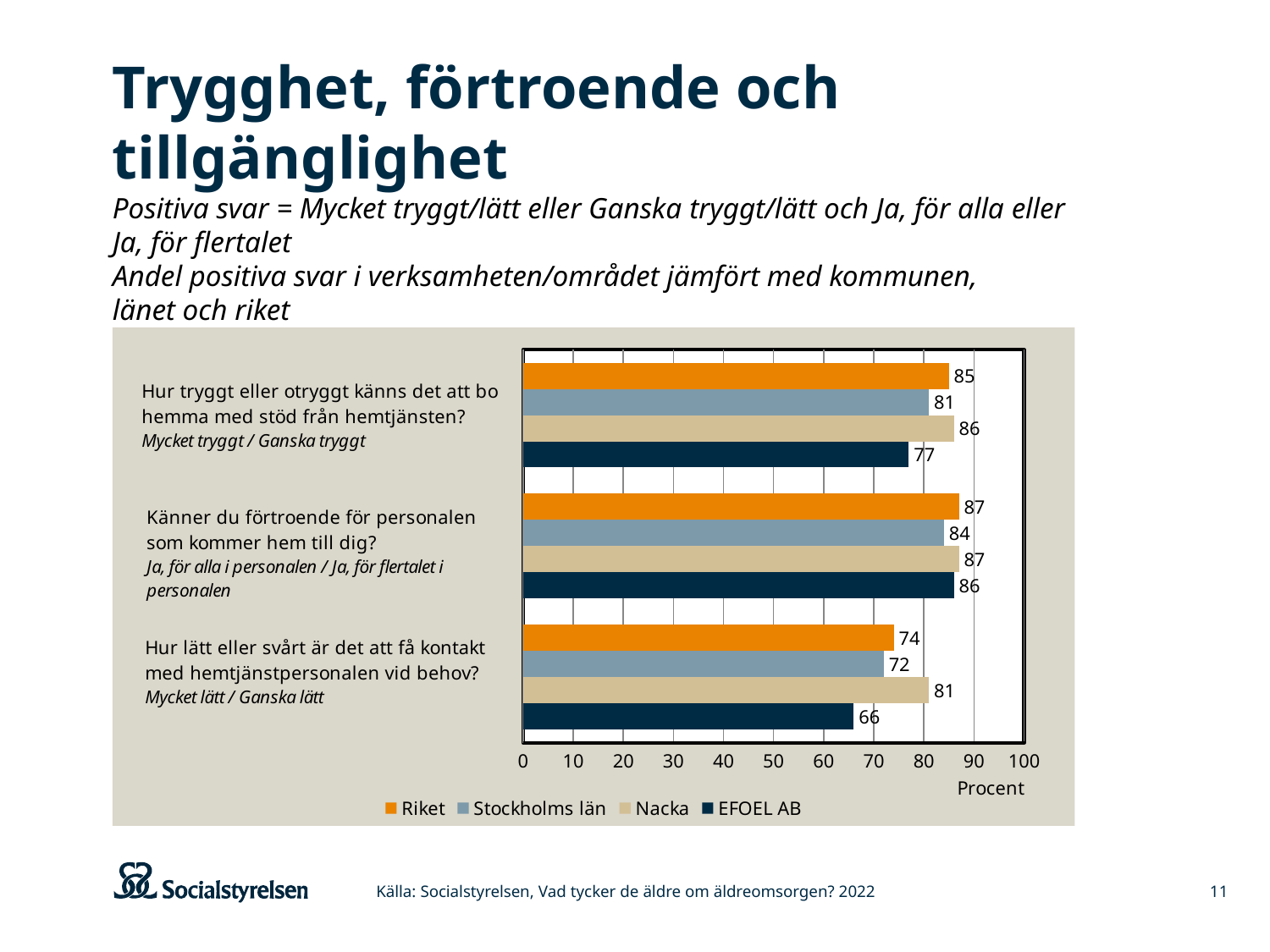
What is the value for EFOEL AB for the question "Hur tryggt eller otryggt känns det att bo hemma med stöd från hemtjänsten?"? 77 Which series has the highest value for the question "Hur tryggt eller otryggt känns det att bo hemma med stöd från hemtjänsten?"? Nacka What label is shown on the horizontal axis of the chart? Procent Which series has the lowest value for the question "Hur lätt eller svårt är det att få kontakt med hemtjänstpersonalen vid behov?"? EFOEL AB How many question categories are plotted on the chart? 3 What is the value for Nacka for the question "Hur lätt eller svårt är det att få kontakt med hemtjänstpersonalen vid behov?"? 81 What is the value for Stockholms län for the question "Känner du förtroende för personalen som kommer hem till dig?"? 84 How many series does the legend list? 4 Which is larger for the question "Hur tryggt eller otryggt känns det att bo hemma med stöd från hemtjänsten?": Riket or Stockholms län? Riket What is the difference between Nacka and EFOEL AB for the question "Hur lätt eller svårt är det att få kontakt med hemtjänstpersonalen vid behov?"? 15 What type of chart is shown on the slide? bar chart Is the value for EFOEL AB for the question "Hur lätt eller svårt är det att få kontakt med hemtjänstpersonalen vid behov?" greater or less than 70? less